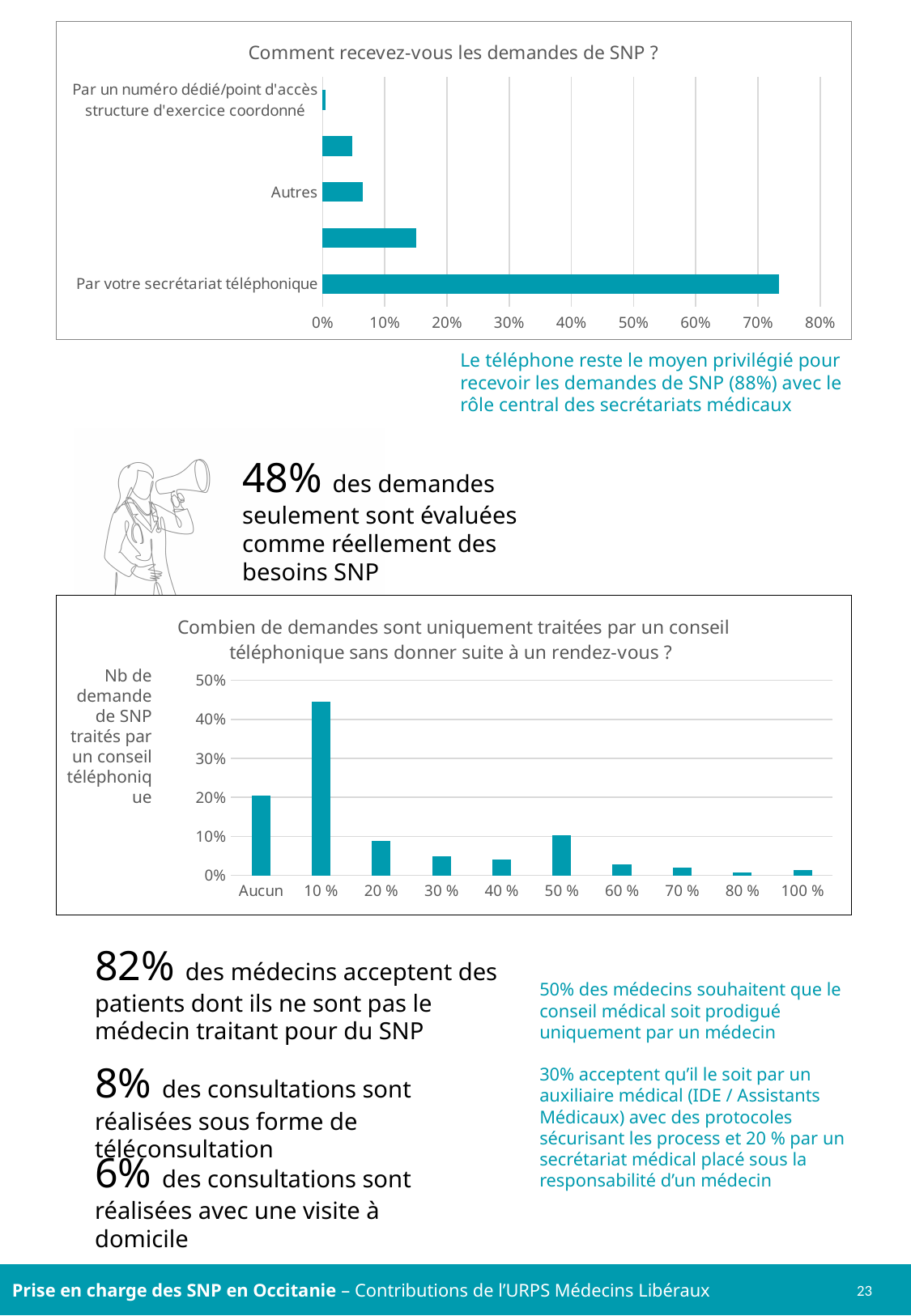
In the chart 'Comment recevez-vous les demandes de SNP ?', is the value for 'Par votre secrétariat téléphonique' greater or less than 60%? greater In the chart 'Combien de demandes sont uniquement traitées par un conseil téléphonique...', how many categories are shown on the x axis? 10 In the chart 'Combien de demandes sont uniquement traitées par un conseil téléphonique...', which category has the highest value? 10 % In the chart 'Comment recevez-vous les demandes de SNP ?', which category has the lowest value? Par un numéro dédié/point d'accès structure d'exercice coordonné What kind of chart is the chart titled 'Comment recevez-vous les demandes de SNP ?'? bar chart In the chart 'Comment recevez-vous les demandes de SNP ?', how many bars are plotted? 5 In the chart 'Combien de demandes sont uniquement traitées par un conseil téléphonique...', do the values generally rise or fall from '10 %' to '80 %' along the x axis? fall In the chart 'Combien de demandes sont uniquement traitées par un conseil téléphonique...', is the value for 'Aucun' greater or less than 10%? greater In the chart 'Comment recevez-vous les demandes de SNP ?', which category has the highest value? Par votre secrétariat téléphonique In the chart 'Comment recevez-vous les demandes de SNP ?', is the value for 'Autres' greater or less than 10%? less In the chart 'Combien de demandes sont uniquement traitées par un conseil téléphonique...', which is larger, the value for 'Aucun' or the value for '20 %'? Aucun What kind of chart is the chart titled 'Combien de demandes sont uniquement traitées par un conseil téléphonique sans donner suite à un rendez-vous ?'? bar chart